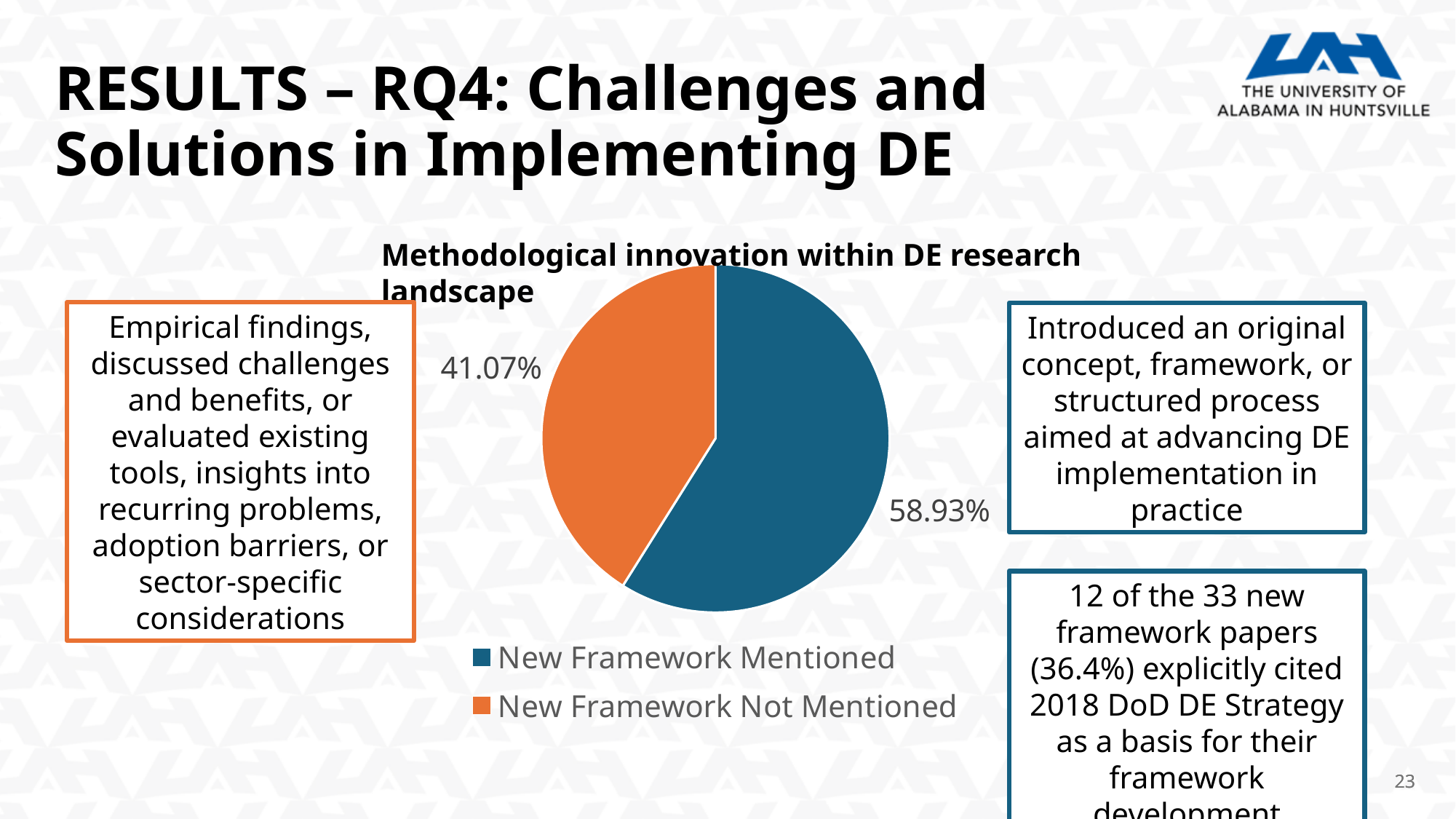
What is the difference in percentage points between the "New Framework Mentioned" and "New Framework Not Mentioned" slices? 17.86 What colour is the "New Framework Not Mentioned" slice? orange What percentage of the pie is labelled "New Framework Not Mentioned"? 41.07% How many slices does the pie chart have? 2 Which slice of the pie is the largest? New Framework Mentioned What type of chart is shown on the slide? pie chart How many entries does the chart legend list? 2 Which is larger: the "New Framework Mentioned" slice or the "New Framework Not Mentioned" slice? New Framework Mentioned Which slice of the pie is the smallest? New Framework Not Mentioned What is the title of the chart? Methodological innovation within DE research landscape What percentage of the pie is labelled "New Framework Mentioned"? 58.93% What share of the pie does the "New Framework Mentioned" slice represent? 58.93%